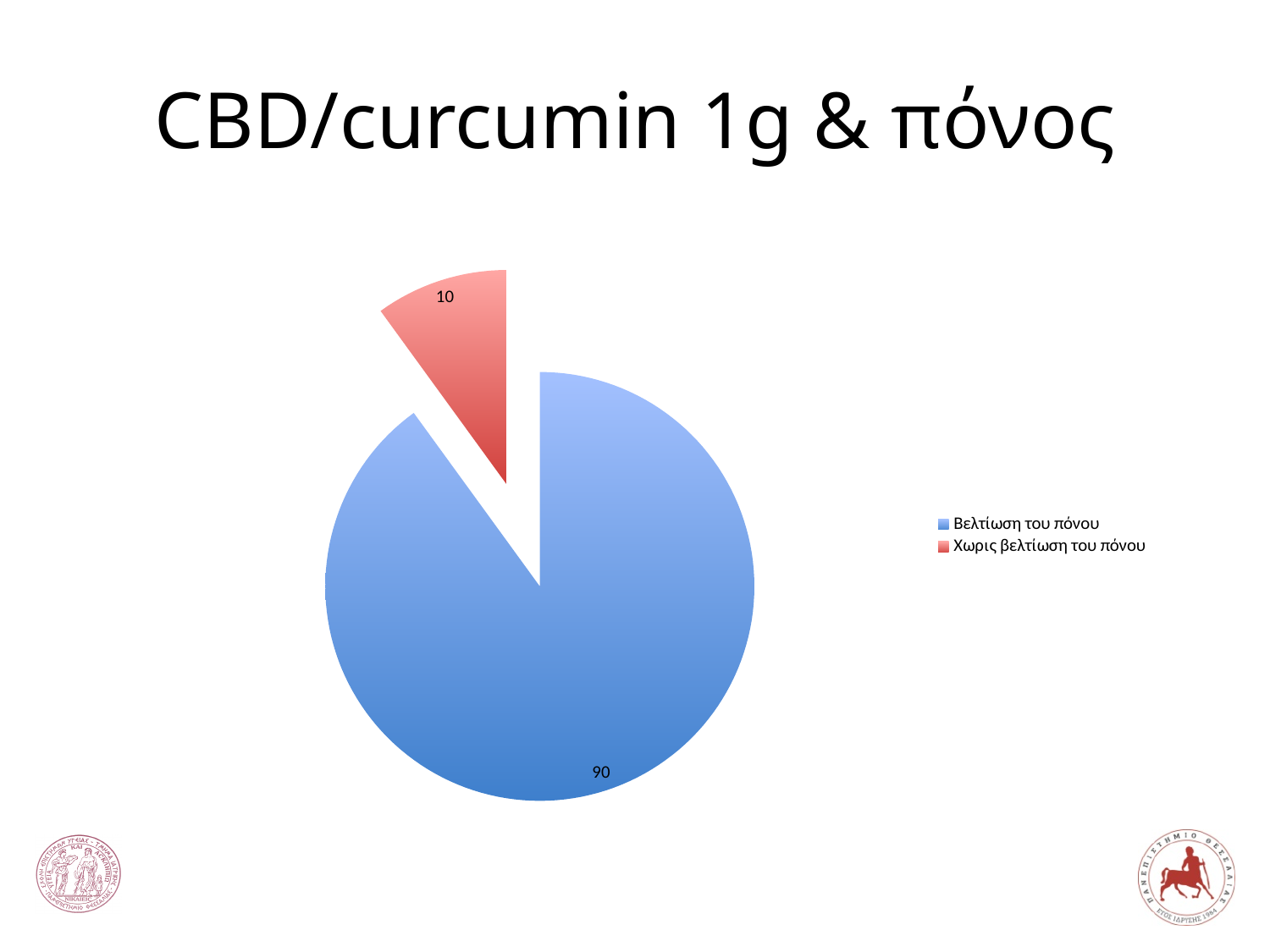
What is the value for Βελτίωση του πόνου? 90 What is the difference between the values for Βελτίωση του πόνου and Χωρις βελτίωση του πόνου? 80 Which category has the smallest slice? Χωρις βελτίωση του πόνου What kind of chart is shown on the slide? pie chart How many slices does the pie chart have? 2 What share of the pie does Χωρις βελτίωση του πόνου represent? 10% What colour is the slice for Χωρις βελτίωση του πόνου? red Which category has the largest slice? Βελτίωση του πόνου What is the value for Χωρις βελτίωση του πόνου? 10 Which is larger, Βελτίωση του πόνου or Χωρις βελτίωση του πόνου? Βελτίωση του πόνου How many entries does the legend list? 2 What is the total of the two slice values? 100